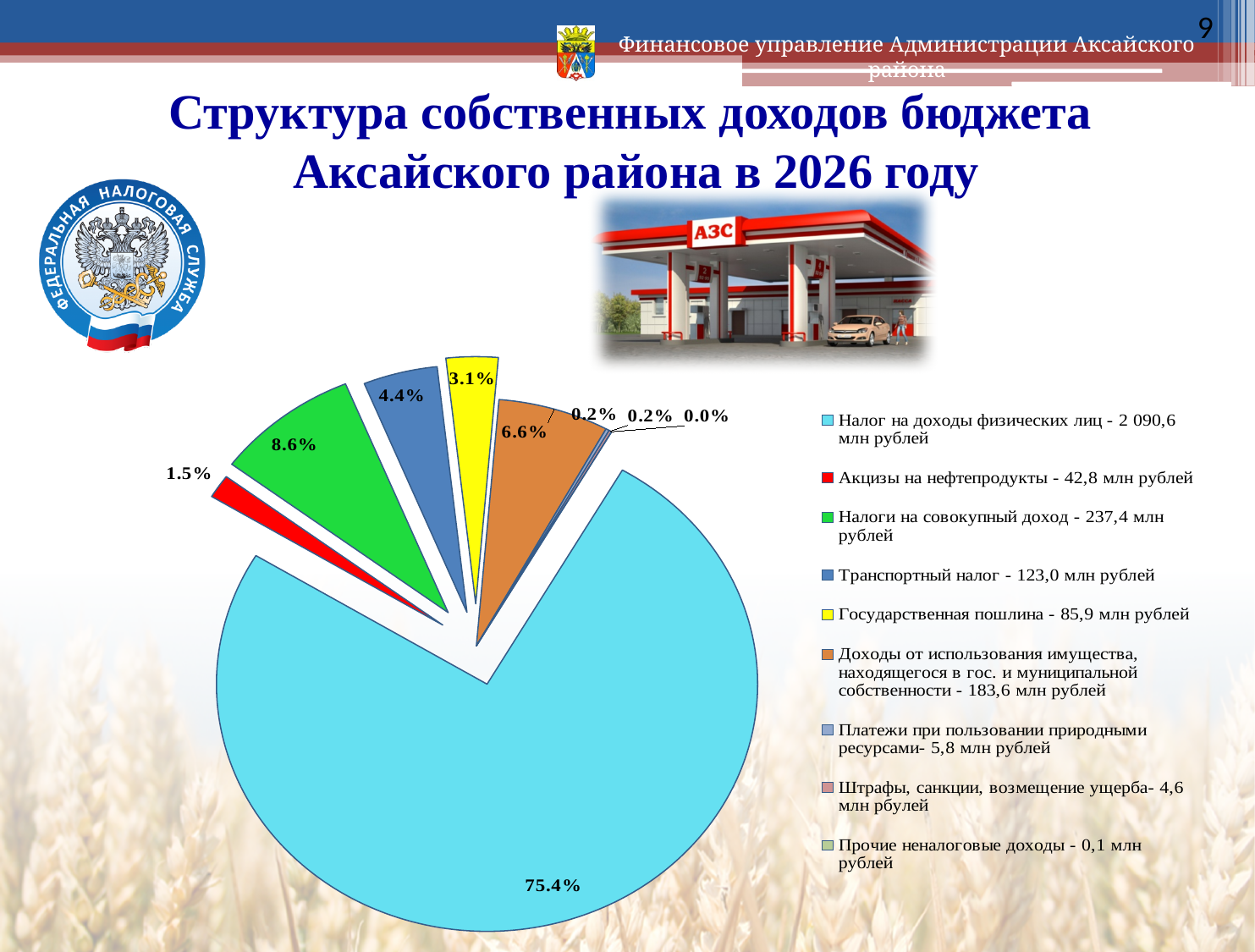
Which category has the largest share of the pie? Налог на доходы физических лиц What share of the pie does "Налог на доходы физических лиц" account for? 75.4% What is the title of the slide containing the pie chart? Структура собственных доходов бюджета Аксайского района в 2026 году According to the legend, what is the amount for "Акцизы на нефтепродукты"? 42,8 млн рублей What share of the pie does "Транспортный налог" (blue slice) account for? 4.4% What is the difference in percentage points between the share of "Налоги на совокупный доход" (8.6%) and "Акцизы на нефтепродукты" (1.5%)? 7.1 percentage points How many categories does the legend of the pie chart list? 9 Which category has the smallest share of the pie? Прочие неналоговые доходы What share of the pie does "Государственная пошлина" (yellow slice) account for? 3.1% What kind of chart is shown on the slide? pie chart Which is larger: the share of "Доходы от использования имущества" (orange) or the share of "Транспортный налог" (blue)? Доходы от использования имущества